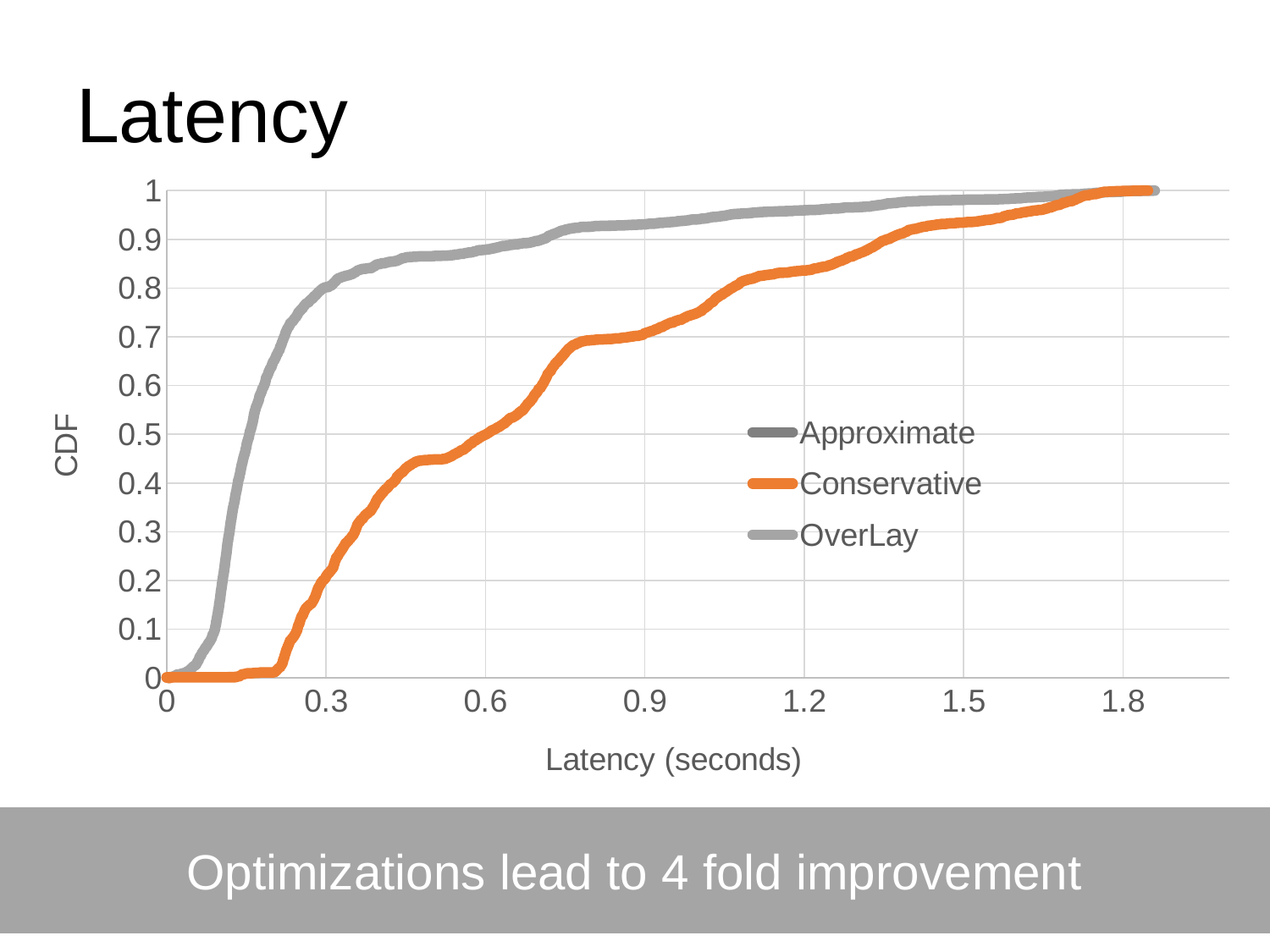
What is the title of the chart? Latency Is the CDF value for Conservative at a latency of 0.9 seconds greater or less than 0.6? greater Is the CDF value for Conservative at a latency of 0.3 seconds greater or less than 0.3? less What kind of chart is shown on the slide? line chart Is the CDF value for Conservative at a latency of 0.2 seconds greater or less than 0.1? less What is the label of the x axis? Latency (seconds) How many series does the legend list? 3 Does the Conservative line rise or fall as latency increases along the x axis? rise How many labelled tick values are shown on the x axis? 7 What is the highest tick value shown on the y axis? 1